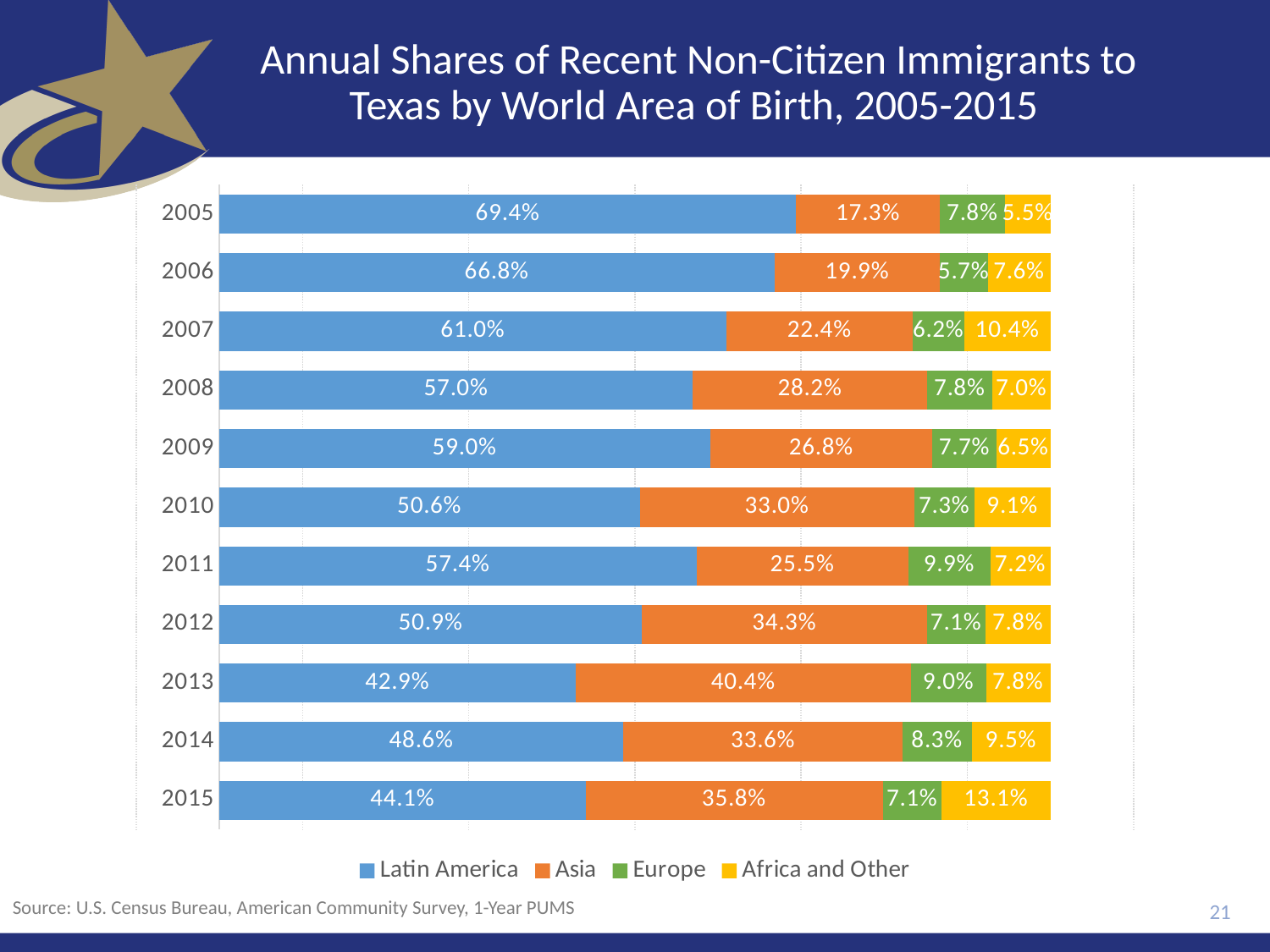
What is the Africa and Other share for 2015? 13.1% By how many percentage points does the Latin America share exceed the Asia share in 2005? 52.1 percentage points What kind of chart is shown on the slide? Stacked bar chart In 2013, which is larger: the Latin America share or the Asia share? Latin America In which year is the Latin America share the highest? 2005 How many series does the legend list? 4 In which year is the Asia share the highest? 2013 How many years are shown on the chart? 11 What is the Asia share for 2013? 40.4% What is the Europe share for 2011? 9.9% In which year is the Latin America share the lowest? 2013 What share of recent non-citizen immigrants to Texas in 2005 were born in Latin America? 69.4%